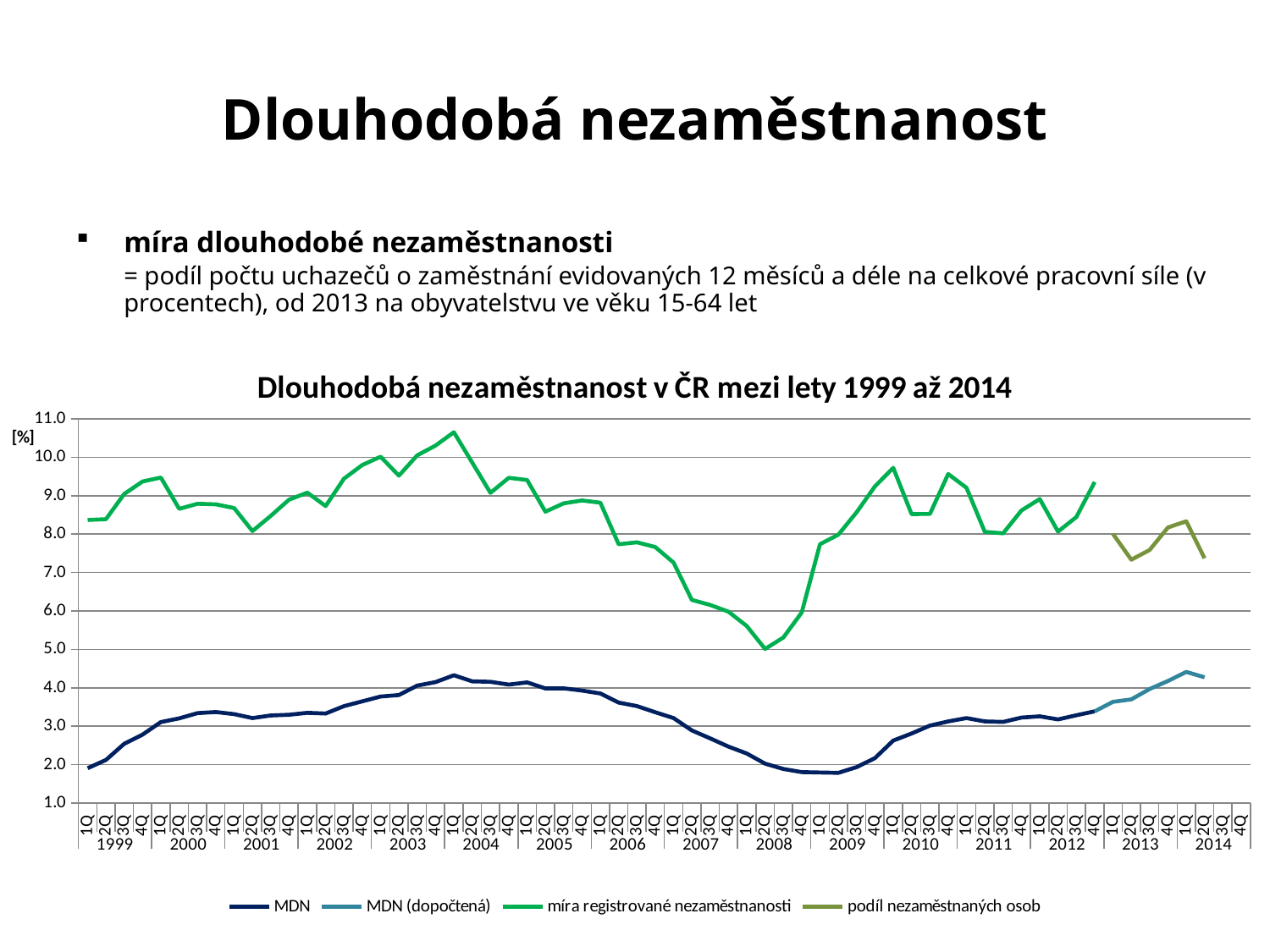
Which series is drawn in green in the chart? míra registrované nezaměstnanosti Is the value of podíl nezaměstnaných osob in 2Q 2013 greater or less than 8.0? less Is the value of míra registrované nezaměstnanosti in 1Q 2004 greater or less than 10.0? greater Is the value of MDN in 1Q 2004 greater or less than 4.0? greater Does the míra registrované nezaměstnanosti series rise or fall between 1Q 2004 and 2Q 2008? fall In which quarter does the míra registrované nezaměstnanosti series reach its lowest value? 2Q 2008 What is the title of the chart? Dlouhodobá nezaměstnanost v ČR mezi lety 1999 až 2014 How many series does the chart legend list? 4 Does the MDN series rise or fall between 1Q 1999 and 1Q 2004? rise What kind of chart is shown on the slide? line chart